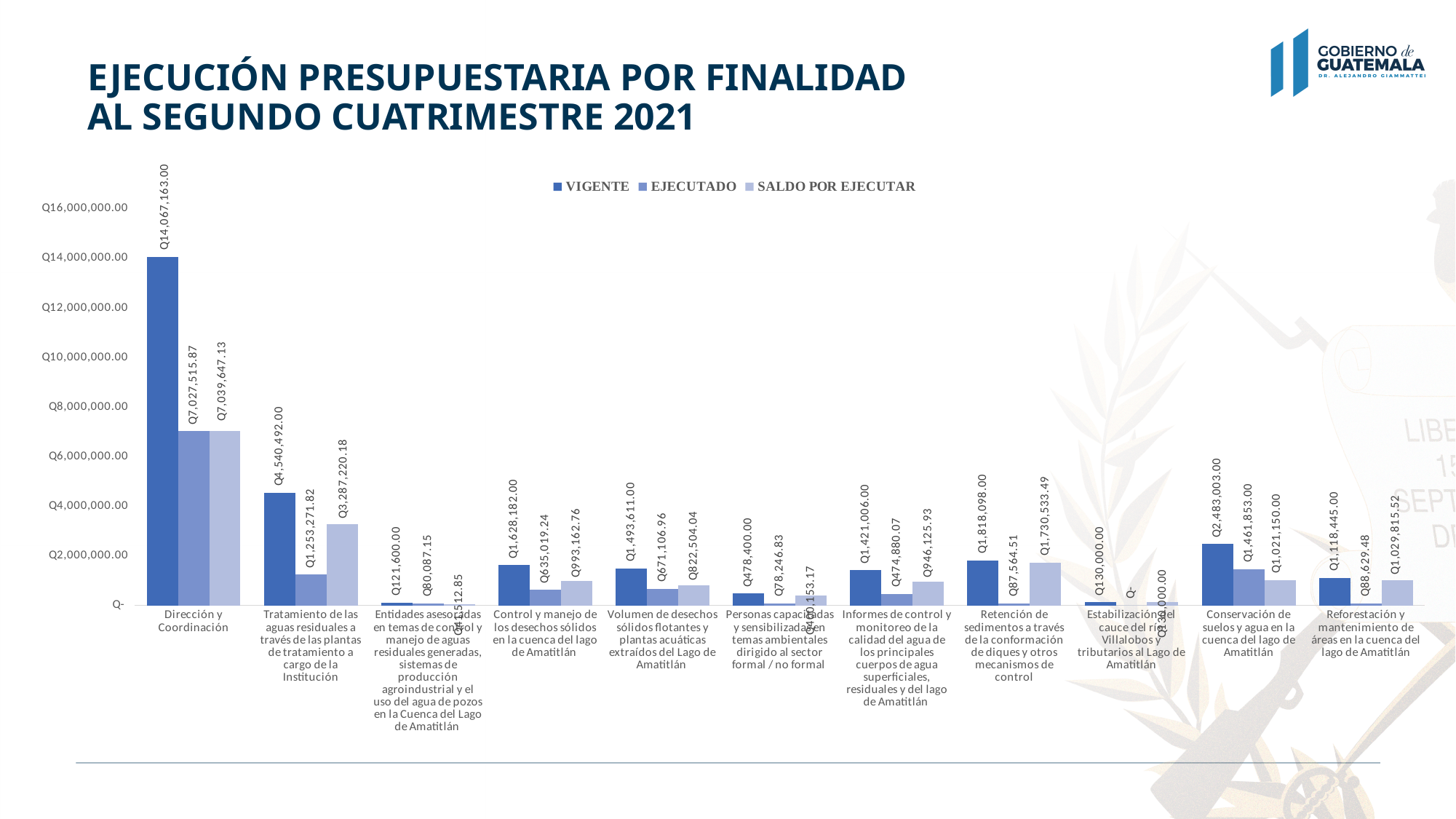
What is the EJECUTADO value for Conservación de suelos y agua en la cuenca del lago de Amatitlán? Q1,461,853.00 How many categories are shown on the x axis? 11 What is the VIGENTE value for Dirección y Coordinación? Q14,067,163.00 Is the VIGENTE value for Dirección y Coordinación greater or less than Q12,000,000.00? greater What is the SALDO POR EJECUTAR value for Retención de sedimentos a través de la conformación de diques y otros mecanismos de control? Q1,730,533.49 What is the difference between the VIGENTE and EJECUTADO values for Tratamiento de las aguas residuales a través de las plantas de tratamiento a cargo de la Institución? Q3,287,220.18 What kind of chart is shown on the slide? Bar chart What is the EJECUTADO value for Estabilización del cauce del río Villalobos y tributarios al Lago de Amatitlán? Q- Which is larger for Volumen de desechos sólidos flotantes y plantas acuáticas extraídos del Lago de Amatitlán: EJECUTADO or SALDO POR EJECUTAR? SALDO POR EJECUTAR Which category has the lowest VIGENTE value? Entidades asesoradas en temas de control y manejo de aguas residuales generadas, sistemas de producción agroindustrial y el uso del agua de pozos en la Cuenca del Lago de Amatitlán Which category has the highest VIGENTE value? Dirección y Coordinación How many series does the legend list? 3